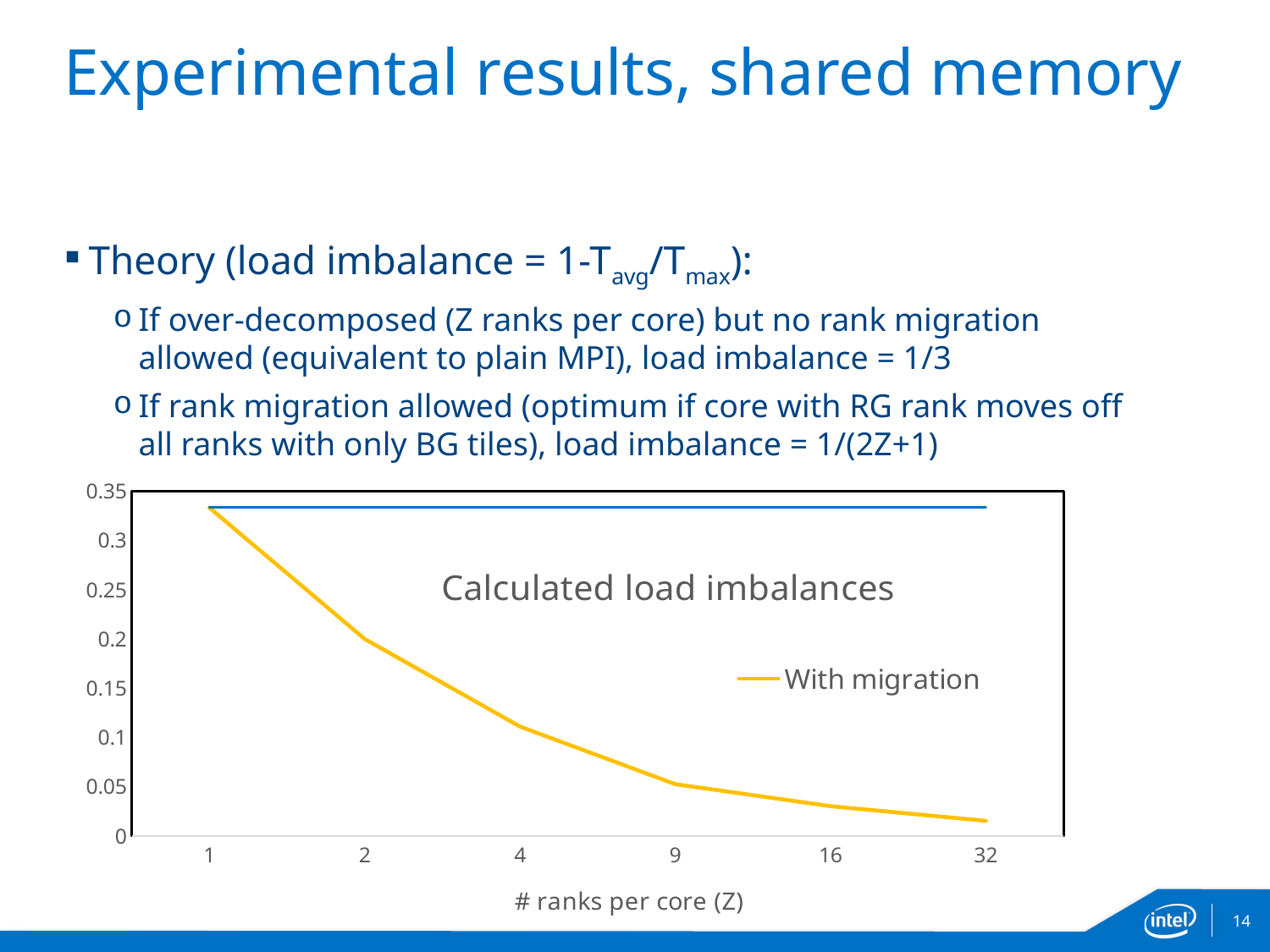
What kind of chart is shown on the slide? line chart Does the 'With migration' line rise or fall as Z increases along the x axis? fall Is the 'With migration' value at Z = 1 greater or less than 0.3? greater At Z = 4, which line is higher: the blue line or the 'With migration' line? the blue line At which value of Z is the 'With migration' line highest? 1 At which value of Z is the 'With migration' line lowest? 32 How many series does the chart's legend list? 1 Is the 'With migration' value at Z = 32 greater or less than 0.05? less What is the title of the chart? Calculated load imbalances How many x-axis categories (values of Z) are plotted on the chart? 6 What is the label of the x axis of the chart? # ranks per core (Z) Is the 'With migration' value at Z = 4 greater or less than 0.15? less